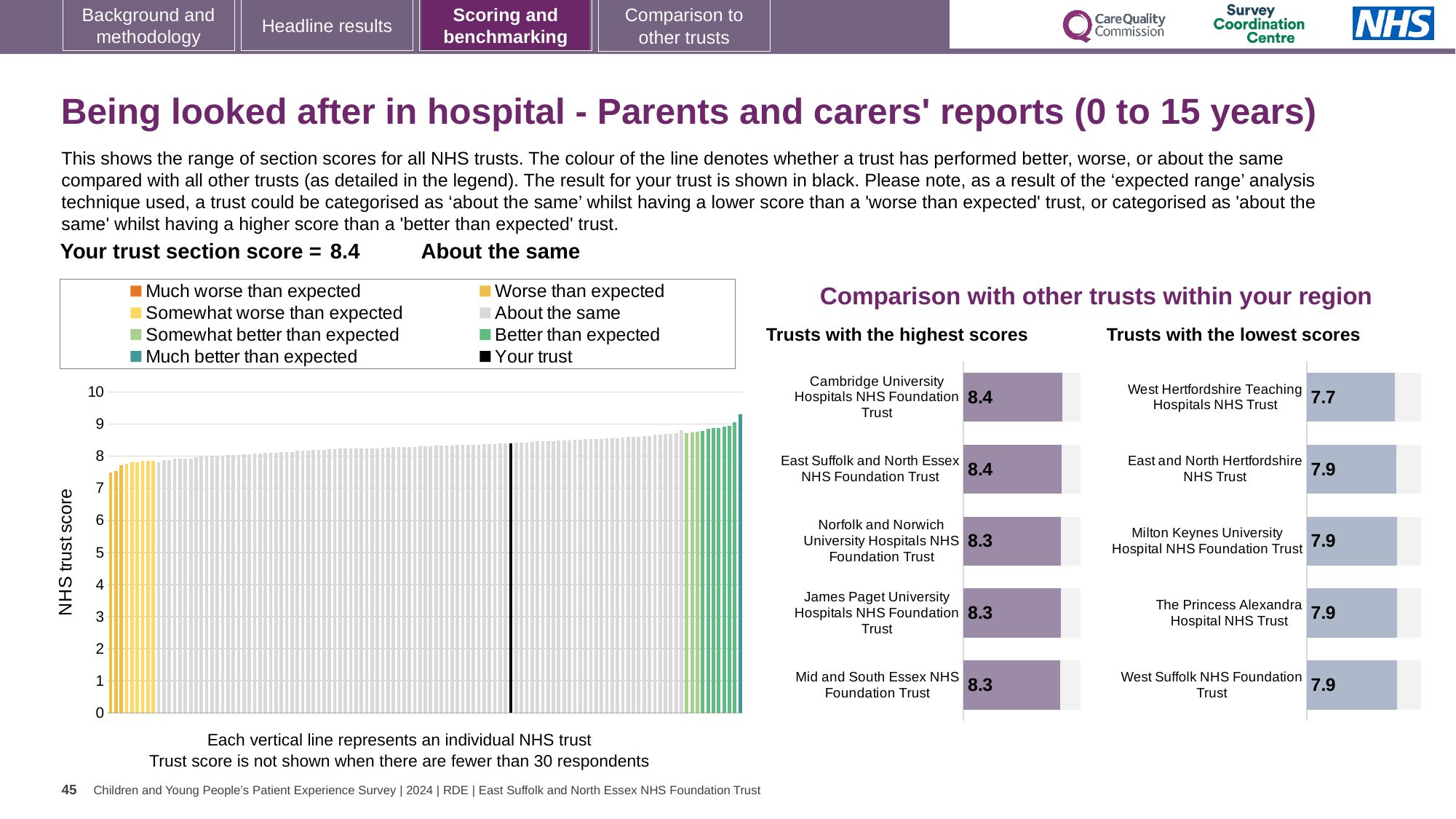
In the 'NHS trust score' chart on the left, is the value for the black 'Your trust' bar greater or less than 8? greater In the 'Trusts with the highest scores' chart, what is the score for Cambridge University Hospitals NHS Foundation Trust? 8.4 In the 'Trusts with the lowest scores' chart, which trust has the lowest score? West Hertfordshire Teaching Hospitals NHS Trust What kind of chart is the 'NHS trust score' chart on the left of the slide? Bar chart In the 'Trusts with the highest scores' chart, what is the score for Mid and South Essex NHS Foundation Trust? 8.3 In the 'Trusts with the lowest scores' chart, what is the score for West Hertfordshire Teaching Hospitals NHS Trust? 7.7 How many trusts are listed in the 'Trusts with the lowest scores' chart? 5 In the 'Trusts with the highest scores' chart, what is the difference between the score for East Suffolk and North Essex NHS Foundation Trust and the score for James Paget University Hospitals NHS Foundation Trust? 0.1 In the 'Trusts with the highest scores' chart, which is larger: the score for Cambridge University Hospitals NHS Foundation Trust or the score for Norfolk and Norwich University Hospitals NHS Foundation Trust? Cambridge University Hospitals NHS Foundation Trust In the 'NHS trust score' chart on the left, do the values rise or fall from left to right? Rise How many entries does the legend of the 'NHS trust score' chart on the left list? 8 In the 'Trusts with the lowest scores' chart, what is the difference between the score for East and North Hertfordshire NHS Trust and the score for West Hertfordshire Teaching Hospitals NHS Trust? 0.2